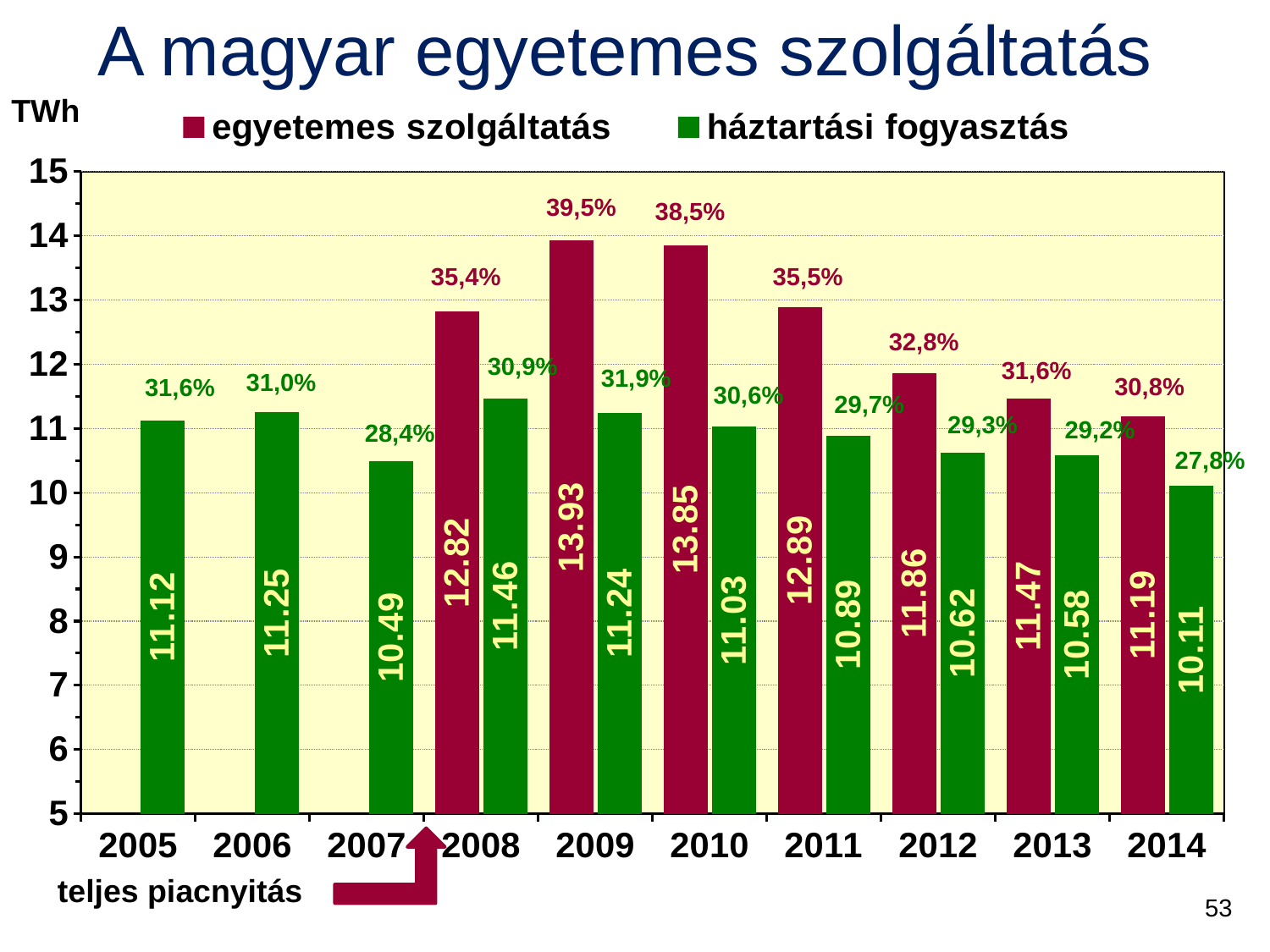
What percentage is printed above the egyetemes szolgáltatás bar for 2010? 38,5% What is the value for háztartási fogyasztás in 2005? 11.12 What is the value for egyetemes szolgáltatás in 2009? 13.93 How many years are shown on the x axis? 10 In which year is the egyetemes szolgáltatás value highest? 2009 Does the egyetemes szolgáltatás value rise or fall from 2009 to 2014? fall Which is larger: háztartási fogyasztás in 2006 or in 2007? 2006 What is the difference between the egyetemes szolgáltatás and háztartási fogyasztás values in 2008? 1.36 What kind of chart is shown on the slide? bar chart How many series does the legend list? 2 In which year is the háztartási fogyasztás value lowest? 2014 What is the value for háztartási fogyasztás in 2014? 10.11